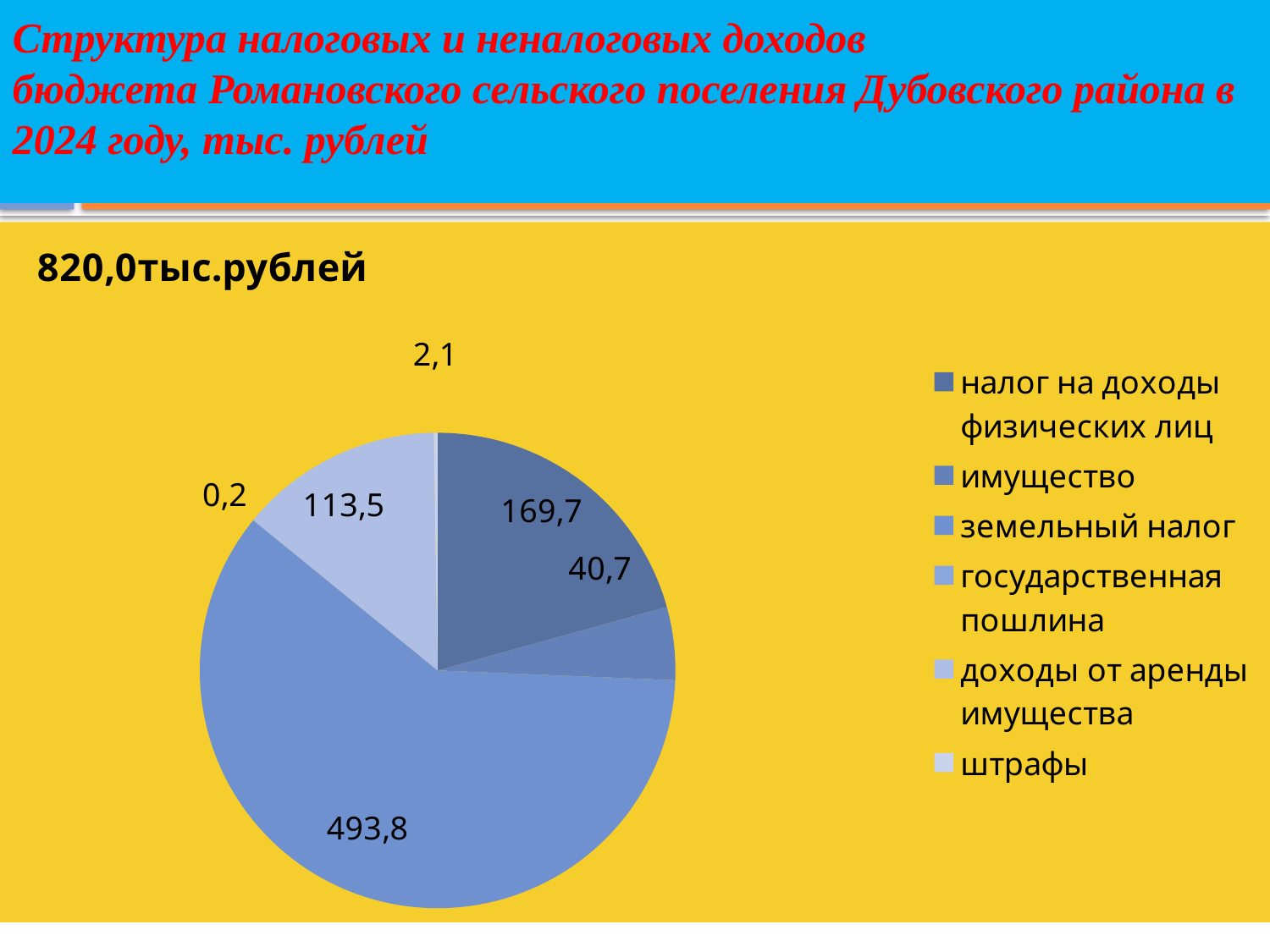
What is the value for налог на доходы физических лиц? 169,7 What is the value for имущество? 40,7 What is the value for земельный налог? 493,8 Which category has the smallest slice? государственная пошлина How many categories does the pie chart show? 6 What is the difference between земельный налог and налог на доходы физических лиц? 324,1 What is the value for доходы от аренды имущества? 113,5 What is the difference between налог на доходы физических лиц and доходы от аренды имущества? 56,2 Which is larger, имущество or штрафы? имущество Which category has the largest slice? земельный налог What is the value for государственная пошлина? 0,2 What kind of chart is shown on the slide? pie chart